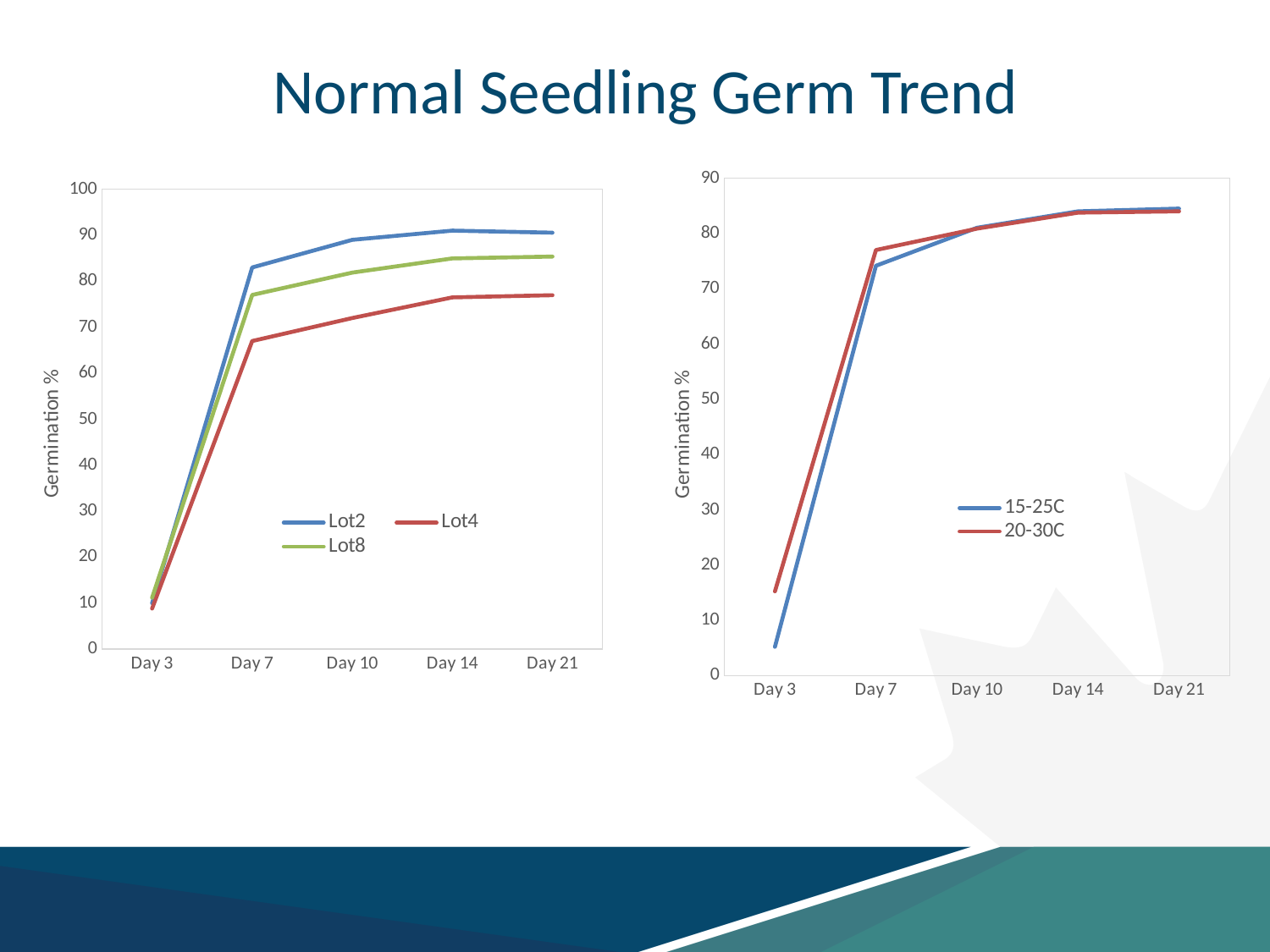
In the left chart, which series has the lowest value at Day 7? Lot4 How many series does the legend of the right chart list? 2 What is the y-axis label of the left chart? Germination % In the right chart, is the value for 15-25C at Day 3 greater or less than 10? less How many points along the x axis does the right chart have? 5 How many series does the legend of the left chart list? 3 In the left chart, is the value for Lot4 at Day 7 greater or less than 70? less What kind of chart is the left chart? line chart In the left chart, is the value for Lot4 at Day 21 greater or less than 70? greater In the right chart, which series has the larger value at Day 3, 15-25C or 20-30C? 20-30C In the right chart, do the values for 20-30C rise or fall from Day 3 to Day 21? rise In the left chart, which series has the highest value at Day 21? Lot2